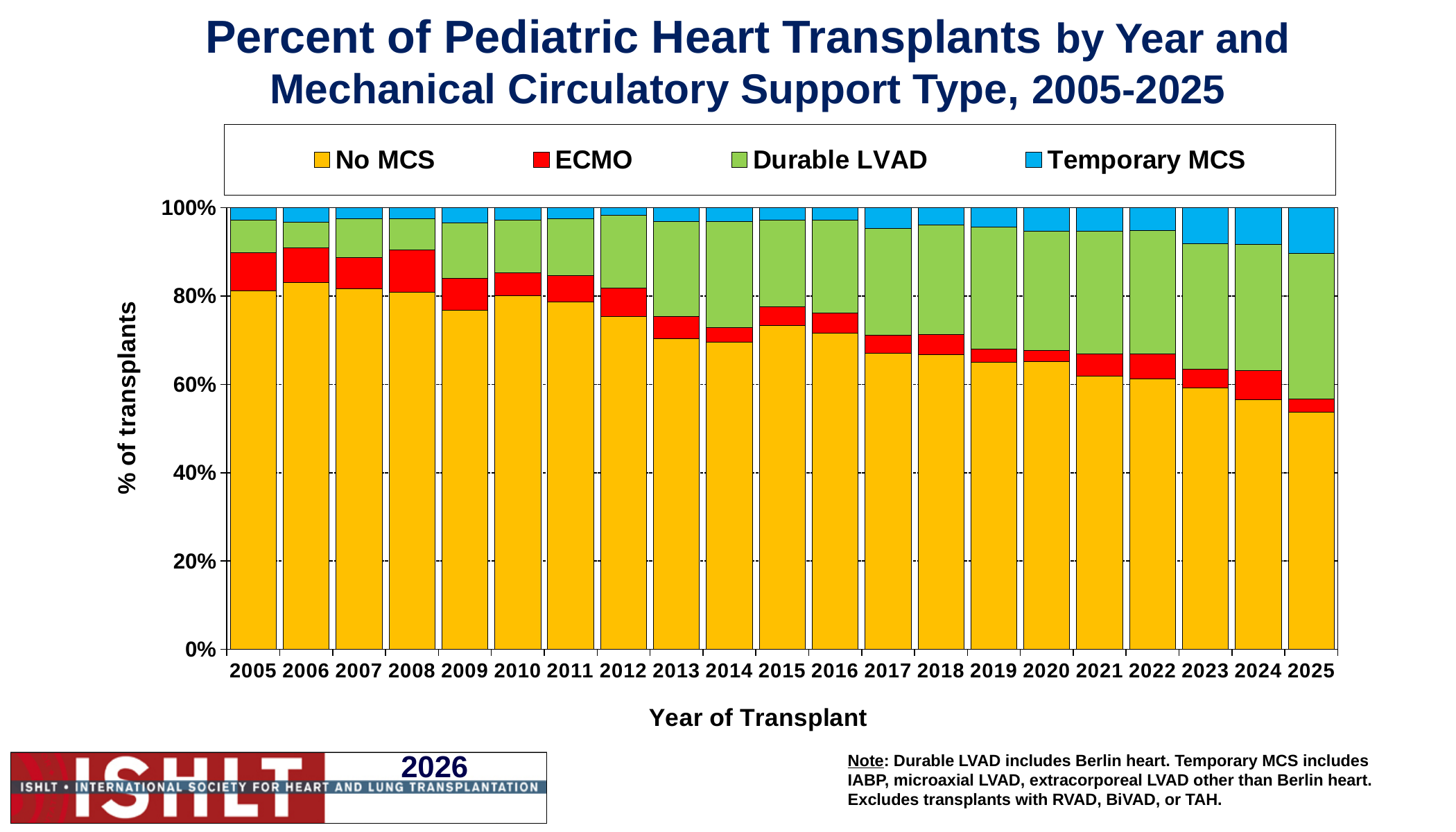
What kind of chart is shown on the slide? Stacked bar chart Which year has the lowest share of No MCS transplants? 2025 Which colour represents ECMO in the chart? Red How many years are plotted along the x axis? 21 Which year has the largest Temporary MCS share? 2025 Is the No MCS share in 2006 greater or less than 80%? greater Is the No MCS share in 2025 greater or less than 60%? less Which year has the highest share of No MCS transplants? 2006 How many series does the legend list? 4 Does the share of No MCS transplants rise or fall from 2005 to 2025? fall What is the label of the y axis? % of transplants Which is larger in 2025, the Durable LVAD share or the ECMO share? Durable LVAD